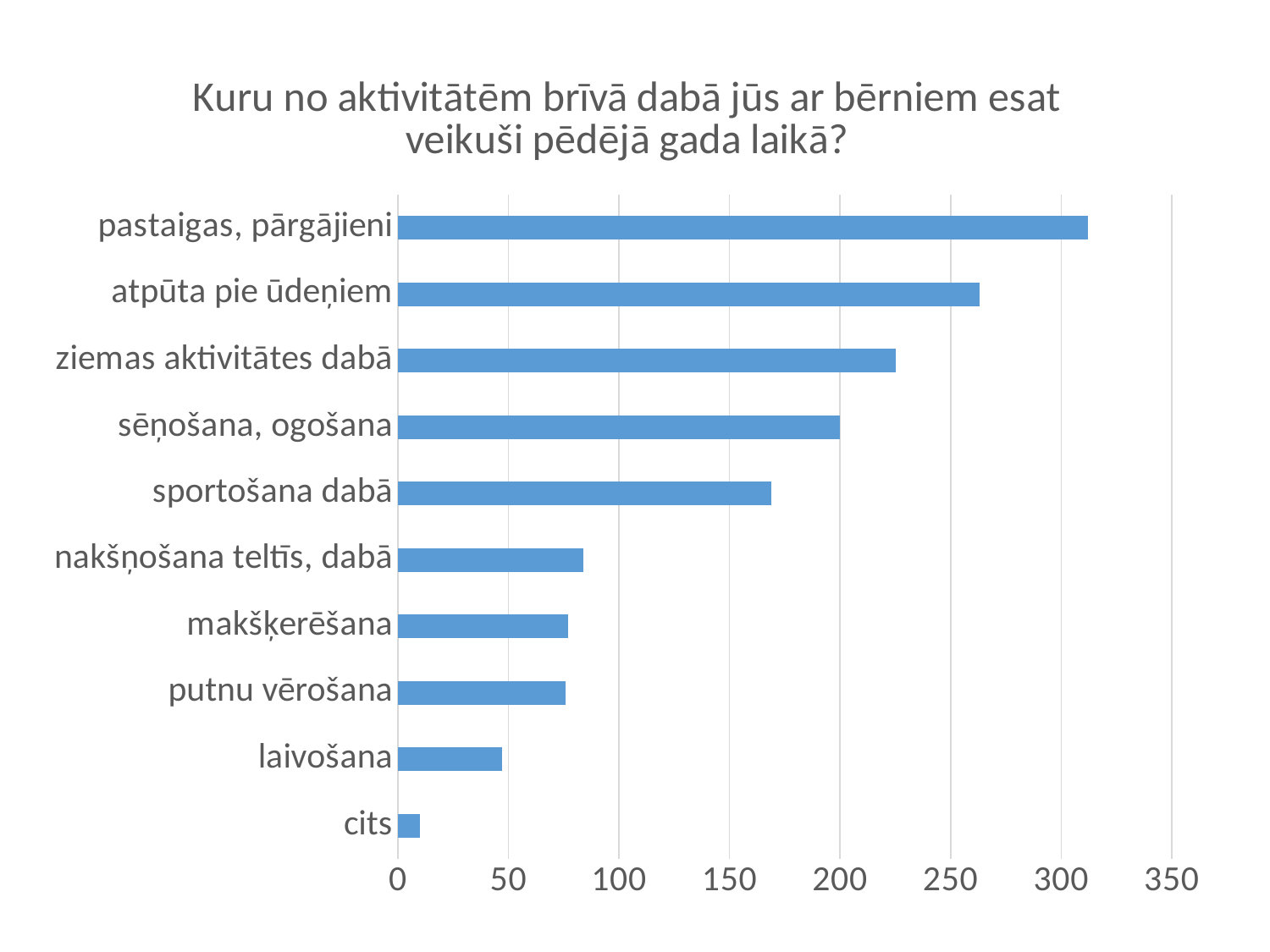
What kind of chart is shown on the slide? bar chart Is the value for pastaigas, pārgājieni greater or less than 300? greater Is the value for nakšņošana teltīs, dabā greater or less than 100? less Is the value for sportošana dabā greater or less than 150? greater How many categories are shown in the chart? 10 Which is larger, the value for atpūta pie ūdeņiem or the value for sēņošana, ogošana? atpūta pie ūdeņiem Which category has the lowest value? cits Which category has the highest value? pastaigas, pārgājieni What is the title of the chart? Kuru no aktivitātēm brīvā dabā jūs ar bērniem esat veikuši pēdējā gada laikā?